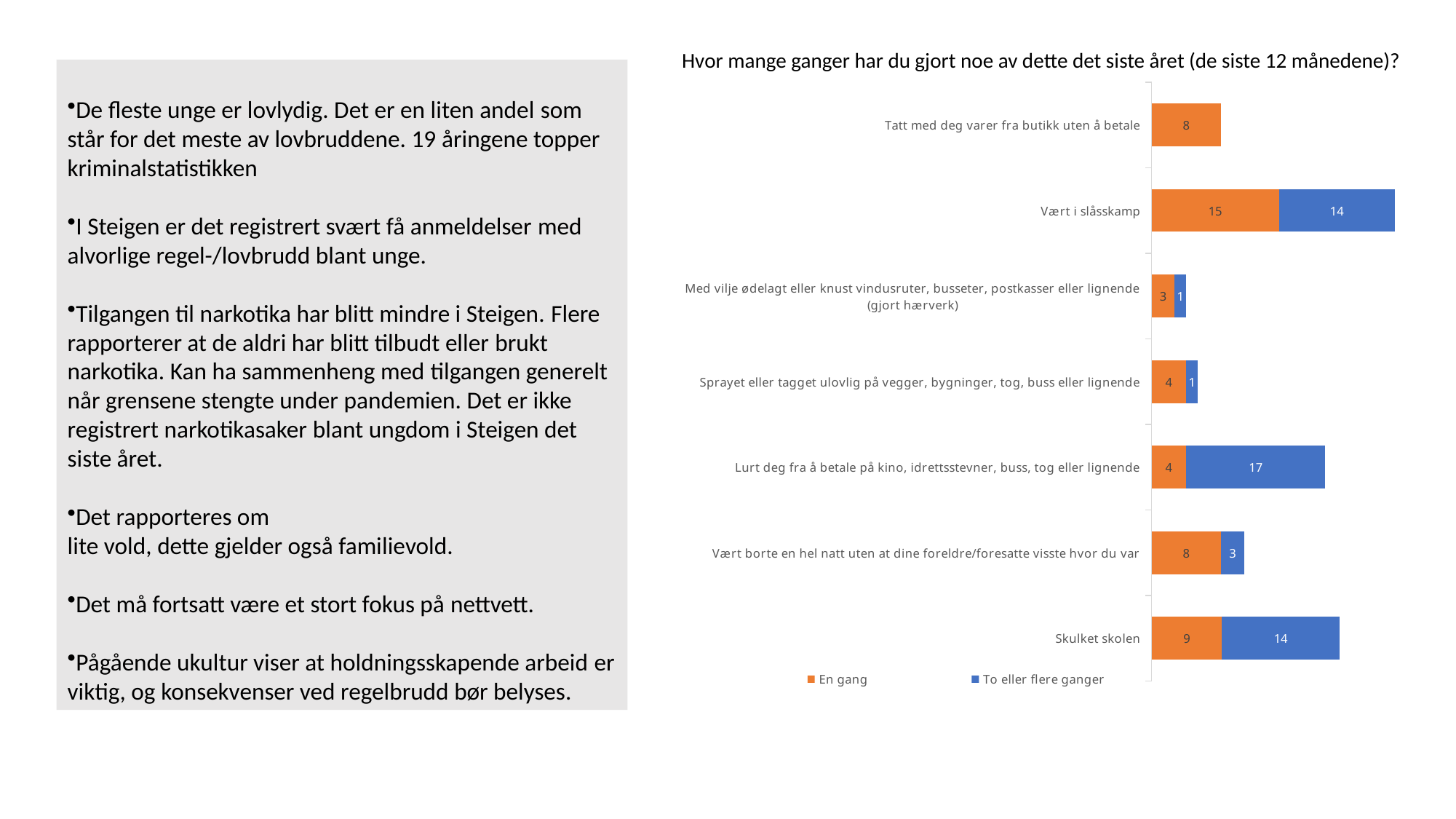
Which category has the highest value for 'To eller flere ganger'? Lurt deg fra å betale på kino, idrettsstevner, buss, tog eller lignende Which category has the highest value for 'En gang'? Vært i slåsskamp What is the total of the stacked bar for 'Skulket skolen'? 23 What is the total of the stacked bar for 'Vært i slåsskamp'? 29 What kind of chart is shown on the slide? bar chart What is the value of 'To eller flere ganger' for 'Lurt deg fra å betale på kino, idrettsstevner, buss, tog eller lignende'? 17 How many categories are shown in the chart? 7 What is the difference between 'To eller flere ganger' and 'En gang' for 'Lurt deg fra å betale på kino, idrettsstevner, buss, tog eller lignende'? 13 How many series does the legend list? 2 What is the value of 'En gang' for 'Vært i slåsskamp'? 15 Which is larger for 'Vært borte en hel natt uten at dine foreldre/foresatte visste hvor du var': 'En gang' or 'To eller flere ganger'? En gang What is the value of 'En gang' for 'Skulket skolen'? 9